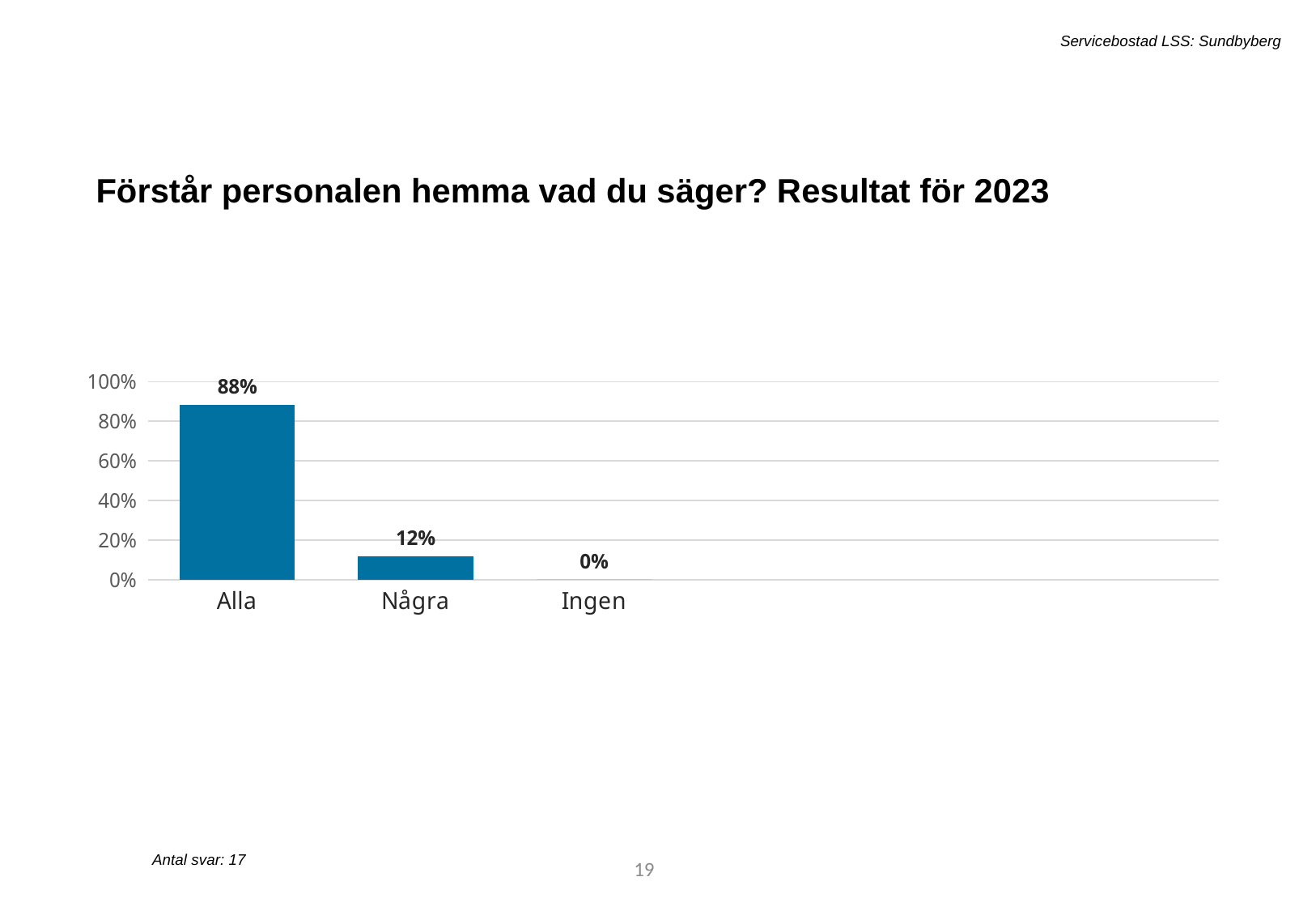
Which category has the lowest value? Ingen Do the values rise or fall from left to right along the x axis? fall Which is larger, the value for Några or the value for Ingen? Några What is the difference between the values for Alla and Några? 76 percentage points How many categories are shown on the x axis? 3 Is the value for Några greater or less than 20%? less Is the value for Alla greater or less than 80%? greater Which category has the highest value? Alla What is the value for Alla? 88% What is the value for Ingen? 0% What kind of chart is shown on the slide? bar chart What is the value for Några? 12%